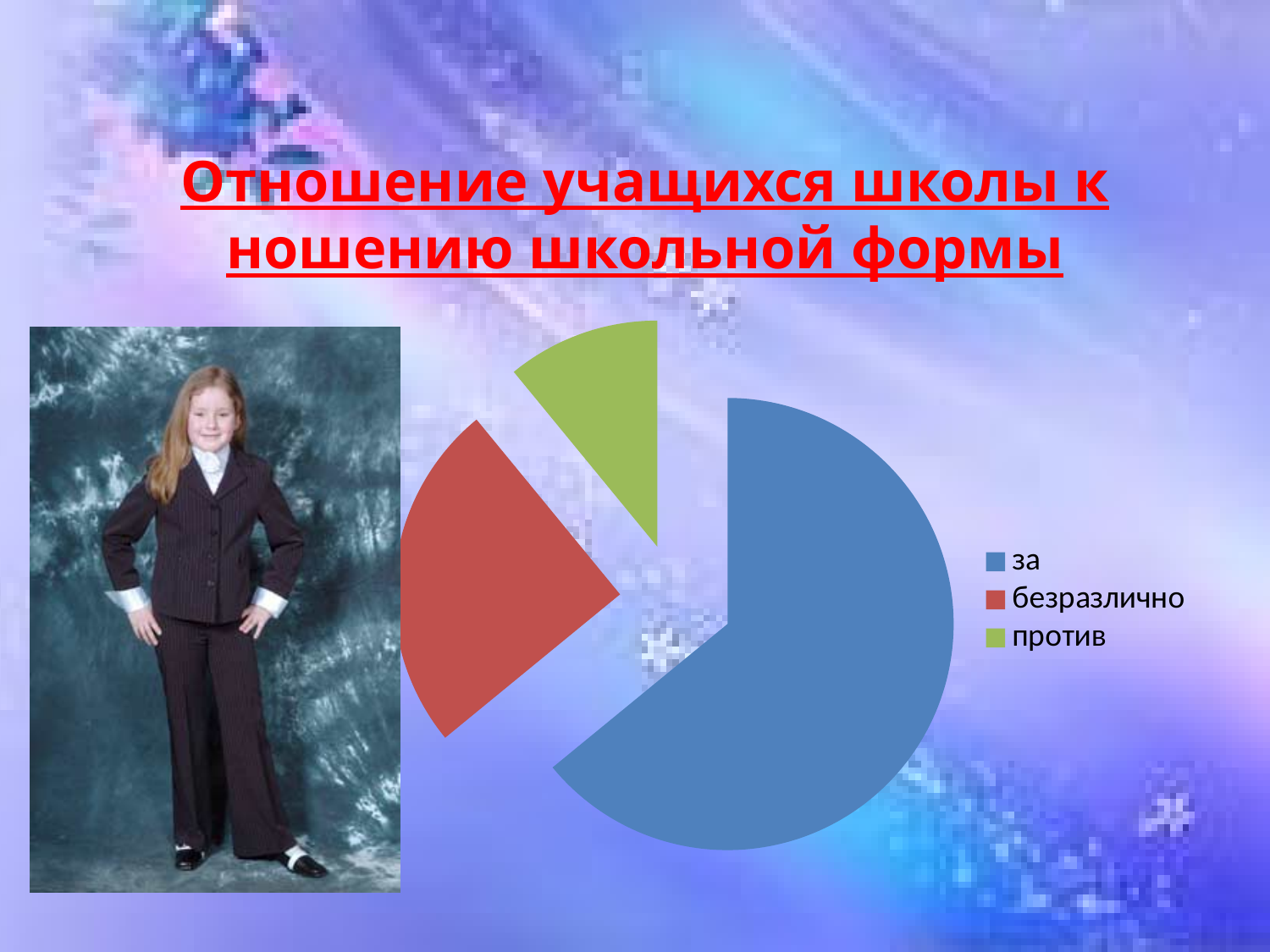
Does the slice for за take up more or less than half of the pie chart? more How many entries does the legend of the pie chart list? 3 Which slice is larger in the pie chart, за or безразлично? за What kind of chart is shown on the slide? pie chart Which category has the smallest slice in the pie chart? против Which slice is larger in the pie chart, безразлично or против? безразлично How many slices does the pie chart have? 3 Which category has the largest slice in the pie chart? за What is the title of the slide containing the pie chart? Отношение учащихся школы к ношению школьной формы What colour is the slice for против in the pie chart? green